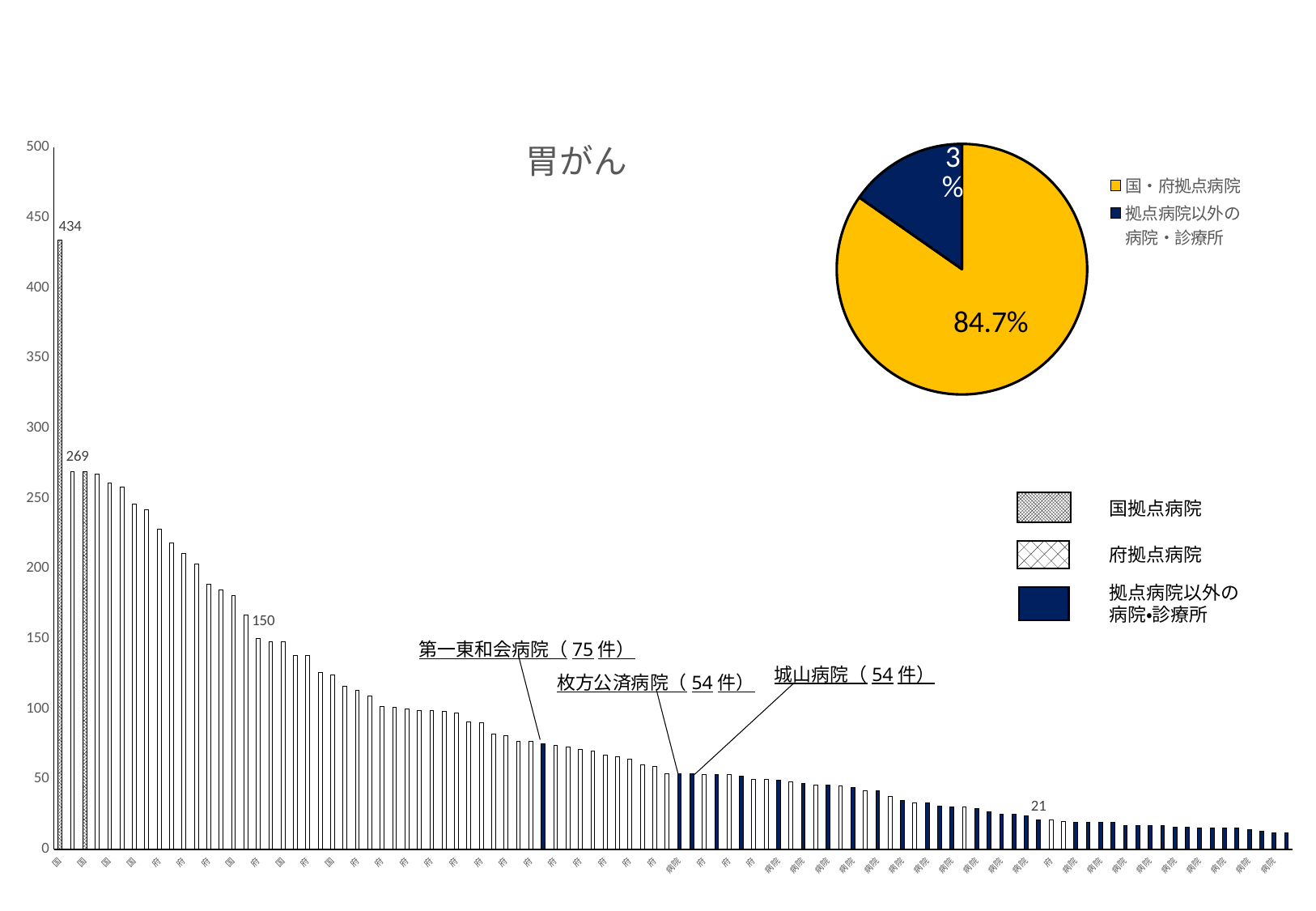
In the bar chart titled 胃がん, which has more cases, 第一東和会病院 or 枚方公済病院? 第一東和会病院 In the bar chart titled 胃がん, how many cases are annotated for 城山病院? 54件 In the bar chart titled 胃がん, what is the value of the second bar from the left? 269 In the bar chart titled 胃がん, what is the difference between the cases for 第一東和会病院 (75件) and 城山病院 (54件)? 21 In the bar chart titled 胃がん, what is the difference between the two tallest bars (434 and 269)? 165 In the bar chart titled 胃がん, how many cases are annotated for 枚方公済病院? 54件 What kind of chart is the large chart titled 胃がん? bar chart In the bar chart titled 胃がん, do the bar values rise or fall from left to right? fall In the bar chart titled 胃がん, what is the value of the tallest bar? 434 In the pie chart at the top right, what share is shown for 国・府拠点病院? 84.7% How many categories does the legend of the bar chart titled 胃がん list? 3 In the bar chart titled 胃がん, how many cases are annotated for 第一東和会病院? 75件